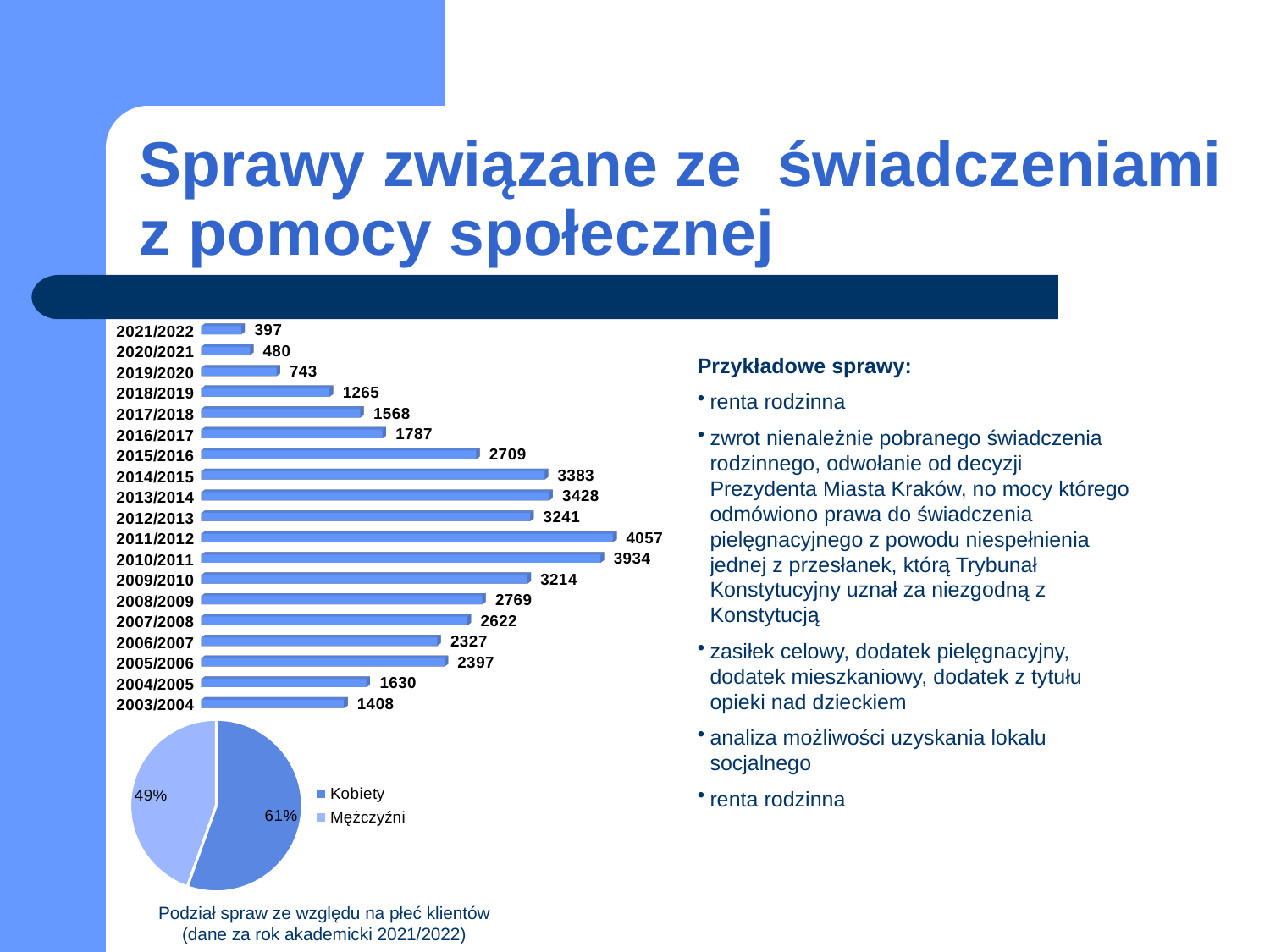
On the bar chart at the top left, which academic year has the lowest value? 2021/2022 On the bar chart at the top left, how many academic years are shown? 19 On the bar chart at the top left, do the values rise or fall from 2015/2016 to 2021/2022? Fall On the bar chart at the top left, which is larger, the value for 2008/2009 or the value for 2007/2008? 2008/2009 What kind of chart is the chart at the top left of the slide? Bar chart On the pie chart at the bottom left, what share is labelled for Kobiety? 61% What is the caption under the pie chart at the bottom left? Podział spraw ze względu na płeć klientów (dane za rok akademicki 2021/2022) On the bar chart at the top left, what is the difference between the values for 2011/2012 and 2010/2011? 123 On the bar chart at the top left, what is the value for 2011/2012? 4057 On the pie chart at the bottom left, how many entries does the legend list? 2 On the bar chart at the top left, what is the value for 2003/2004? 1408 On the bar chart at the top left, which academic year has the highest value? 2011/2012